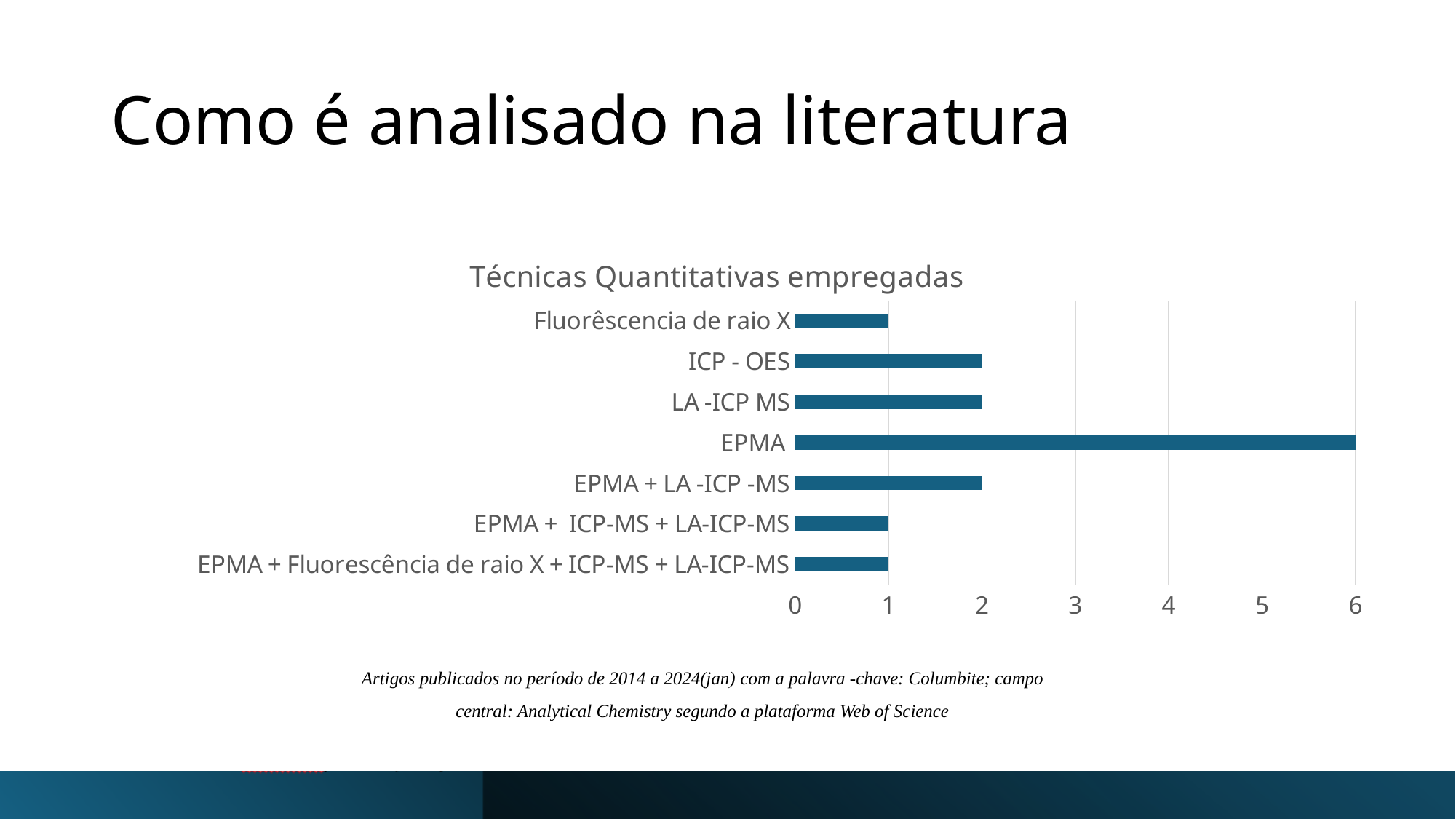
What is the difference between the value for EPMA and the value for LA -ICP MS? 4 What is the maximum value shown on the horizontal axis? 6 What is the value for EPMA + LA -ICP -MS? 2 What is the value for Fluorêscencia de raio X? 1 What type of chart is shown on the slide? bar chart Is the value for EPMA greater or less than 4? greater Which technique has the highest value in the chart? EPMA What is the value for EPMA? 6 How many categories (techniques) are shown in the chart? 7 Which is larger, the value for ICP - OES or the value for EPMA + ICP-MS + LA-ICP-MS? ICP - OES What is the title of the chart? Técnicas Quantitativas empregadas What is the value for ICP - OES? 2